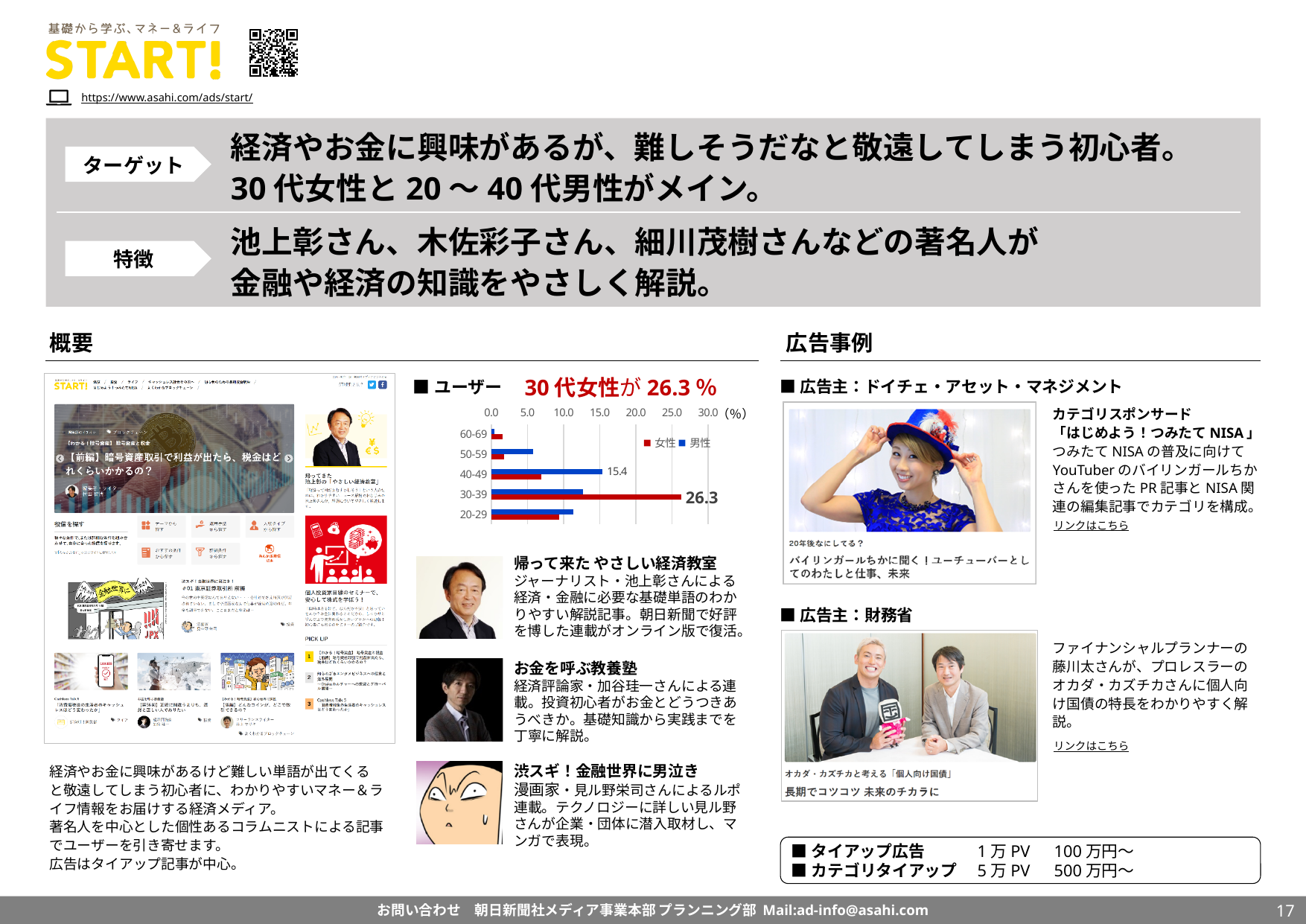
What is the value for 女性 in the 30-39 age group in the ユーザー chart? 26.3 What kind of chart is the ユーザー chart? bar chart Which age group has the lowest 女性 value in the ユーザー chart? 60-69 How many series does the legend of the ユーザー chart list? 2 What is the value for 男性 in the 40-49 age group in the ユーザー chart? 15.4 What is the difference between the 女性 value for 30-39 and the 男性 value for 40-49 in the ユーザー chart? 10.9 How many age groups are shown in the ユーザー chart? 5 In the 40-49 age group, which is larger in the ユーザー chart, 女性 or 男性? 男性 Is the 女性 value for the 50-59 age group greater or less than 5.0? less Which age group has the highest 女性 value in the ユーザー chart? 30-39 Which age group has the highest 男性 value in the ユーザー chart? 40-49 In the 30-39 age group, which is larger in the ユーザー chart, 女性 or 男性? 女性